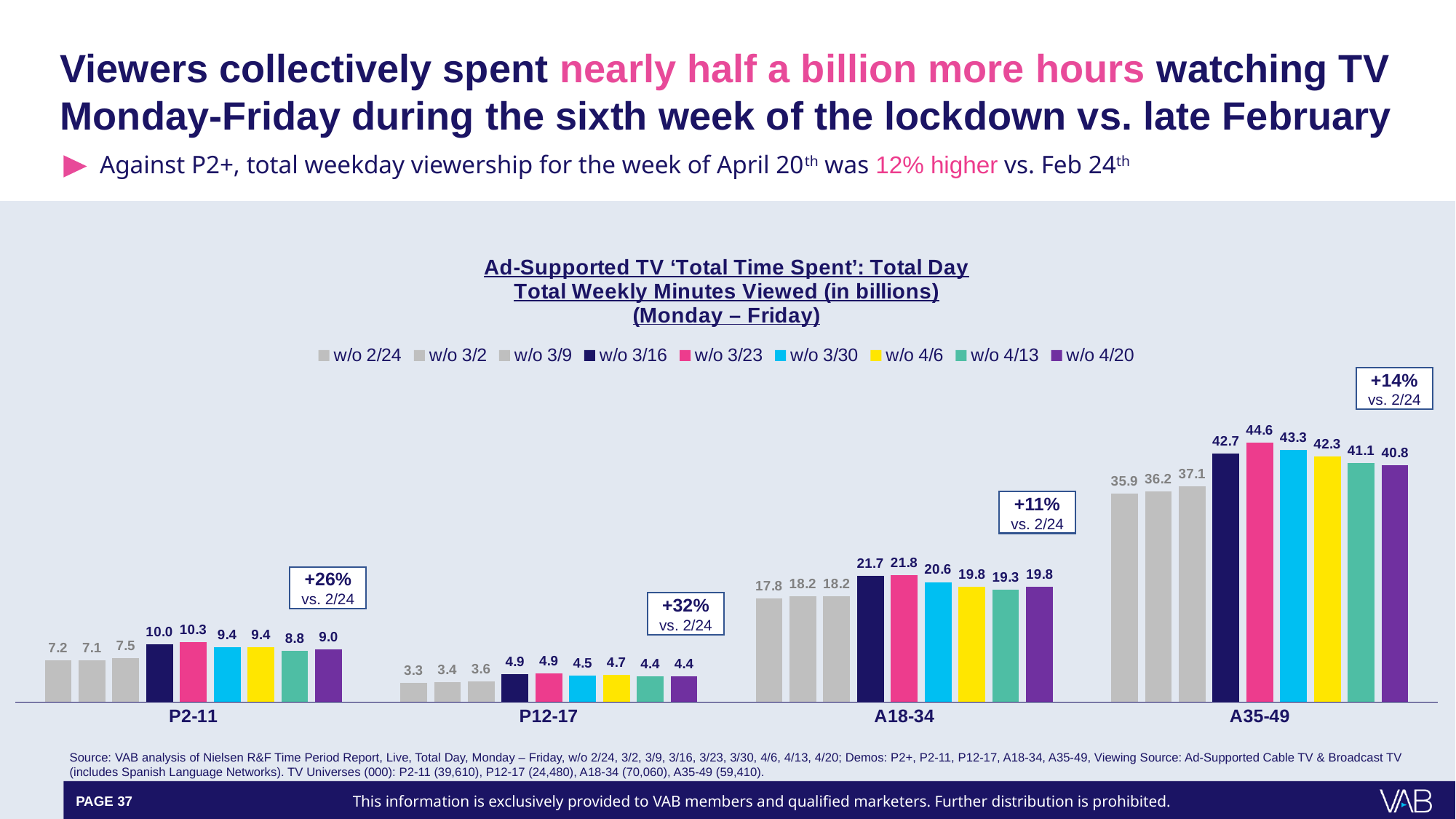
What is the value for A18-34 in the w/o 3/16 series? 21.7 Which is larger for A18-34: the w/o 3/30 value or the w/o 4/13 value? w/o 3/30 How many series does the legend list? 9 How many demographic categories are shown on the x axis? 4 What percentage change vs. 2/24 is annotated above the P12-17 group? +32% What kind of chart is shown on the slide? Bar chart What is the difference between the w/o 4/20 and w/o 2/24 values for A35-49? 4.9 Which week has the highest value for A35-49? w/o 3/23 What is the value for A35-49 in the w/o 3/23 series? 44.6 What is the value for P2-11 in the w/o 2/24 series? 7.2 What is the value for P12-17 in the w/o 4/20 series? 4.4 Which week has the lowest value for P12-17? w/o 2/24